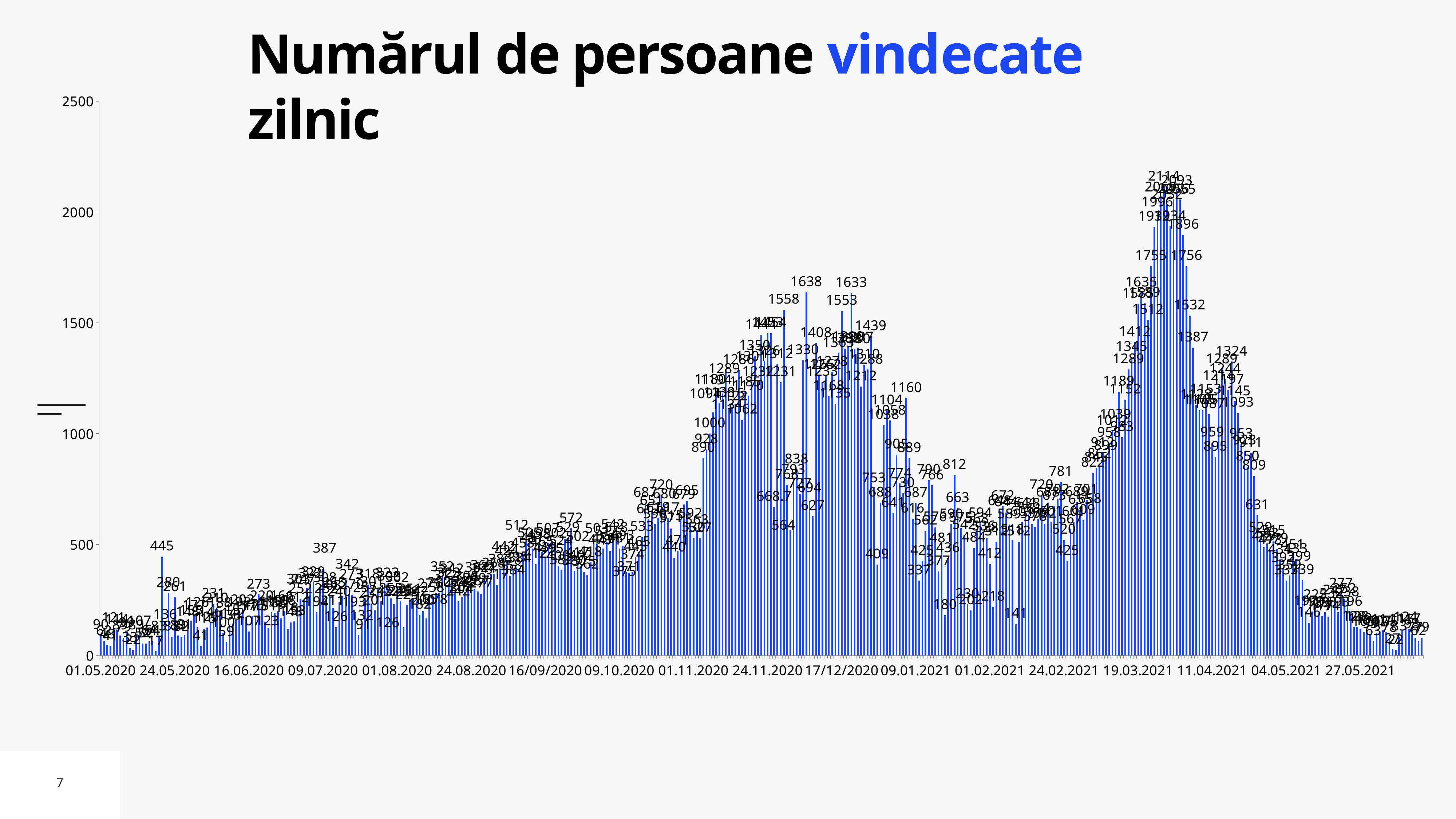
What is the highest value labelled on any bar in the chart? 2114 What value is labelled on the tallest bar near the 24.05.2020 tick? 445 What is the difference between the highest labelled value of the spring 2021 peak (2114) and the highest labelled value of the late 2020 peak (1638)? 476 What value is labelled on the tallest bar near the 09.07.2020 tick? 387 Which is larger: the highest bar in the late 2020 peak (1638) or the highest bar in the spring 2021 peak (2114)? the spring 2021 peak (2114) What kind of chart is shown on the slide? bar chart Is the tallest bar near the 24.05.2020 tick greater or less than 500? less What is the highest tick value shown on the vertical axis? 2500 Do the bar values generally rise or fall between the 11.04.2021 and 04.05.2021 ticks? fall Do the bar values generally rise or fall between the 01.02.2021 and 19.03.2021 ticks? rise What is the highest labelled value in the peak between 24.11.2020 and 17/12/2020? 1638 What is the title of the chart on the slide? Numărul de persoane vindecate zilnic